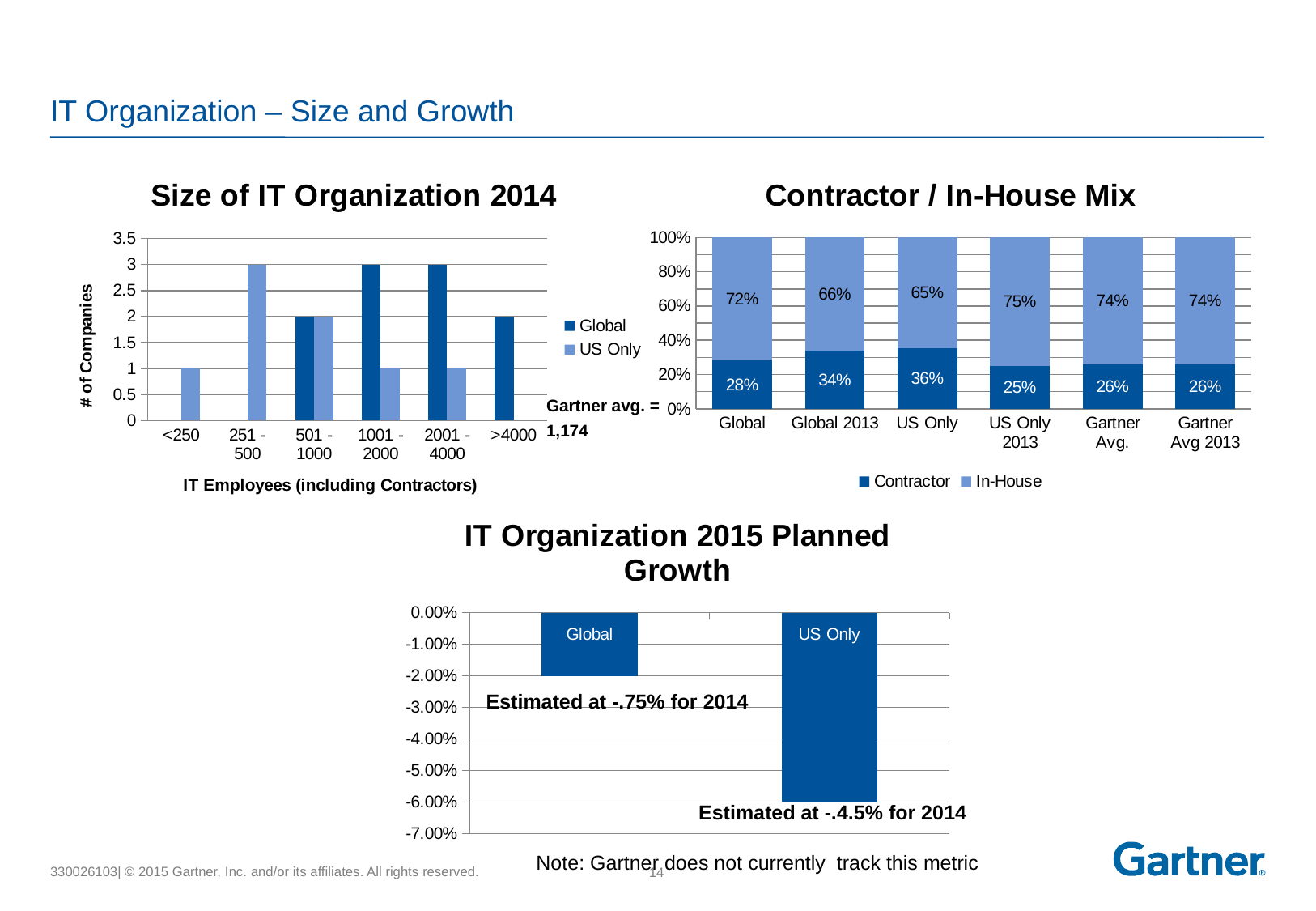
In the 'IT Organization 2015 Planned Growth' chart, what is the planned growth value for US Only? -6.00% In the 'Contractor / In-House Mix' chart, how many series does the legend list? 2 In the 'Size of IT Organization 2014' chart, what is the Gartner average number of IT employees shown next to the chart? 1,174 In the 'Size of IT Organization 2014' chart, how many categories are shown on the x axis? 6 In the 'Contractor / In-House Mix' chart, what is the In-House share for US Only 2013? 75% In the 'Contractor / In-House Mix' chart, what is the Contractor share for US Only? 36% In the 'Contractor / In-House Mix' chart, what is the difference between the In-House share for Global and for Global 2013? 6% In the 'Size of IT Organization 2014' chart, is the Global value for 1001 - 2000 larger or smaller than the US Only value for 1001 - 2000? larger In the 'Contractor / In-House Mix' chart, which category has the highest Contractor share? US Only In the 'Contractor / In-House Mix' chart, which category has the lowest Contractor share? US Only 2013 In the 'Size of IT Organization 2014' chart, how many companies are in the 251 - 500 category for US Only? 3 What kind of chart is 'IT Organization 2015 Planned Growth'? bar chart